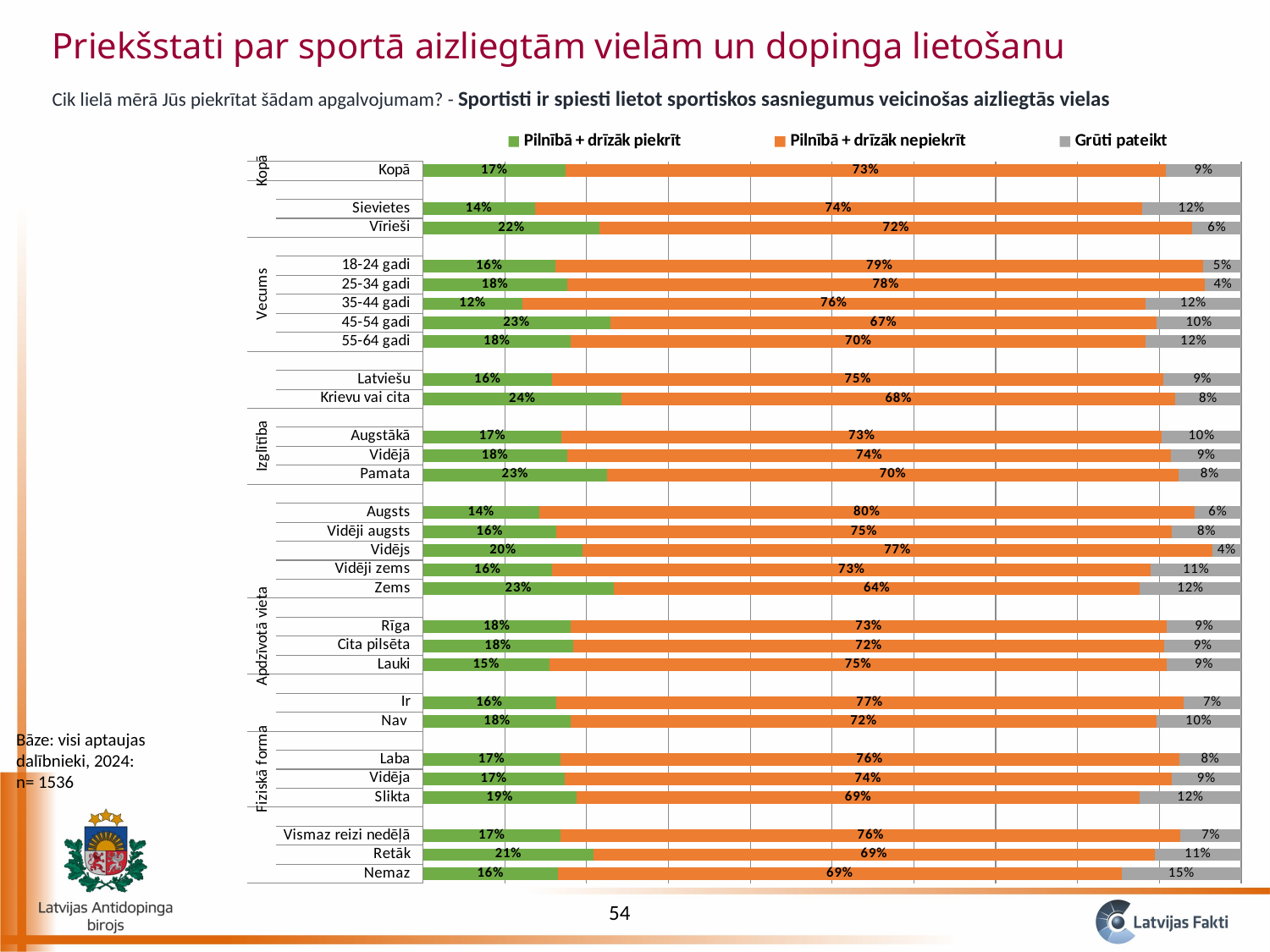
Which category has the highest value for "Pilnībā + drīzāk piekrīt"? Krievu vai cita How many series does the legend list? 3 Which has a larger "Pilnībā + drīzāk piekrīt" value, Sievietes or Vīrieši? Vīrieši What is the difference between the "Pilnībā + drīzāk nepiekrīt" values for 18-24 gadi and 45-54 gadi? 12% What is the value of "Grūti pateikt" for Nemaz? 15% What kind of chart is shown on the slide? Stacked bar chart Which category has the highest value for "Pilnībā + drīzāk nepiekrīt"? Augsts What is the total of the stacked bar for Zems? 99% Which category has the lowest value for "Pilnībā + drīzāk piekrīt"? 35-44 gadi What is the value of "Pilnībā + drīzāk piekrīt" for Kopā? 17% What is the value of "Pilnībā + drīzāk nepiekrīt" for Vīrieši? 72% What colour represents "Grūti pateikt" in the chart? Grey